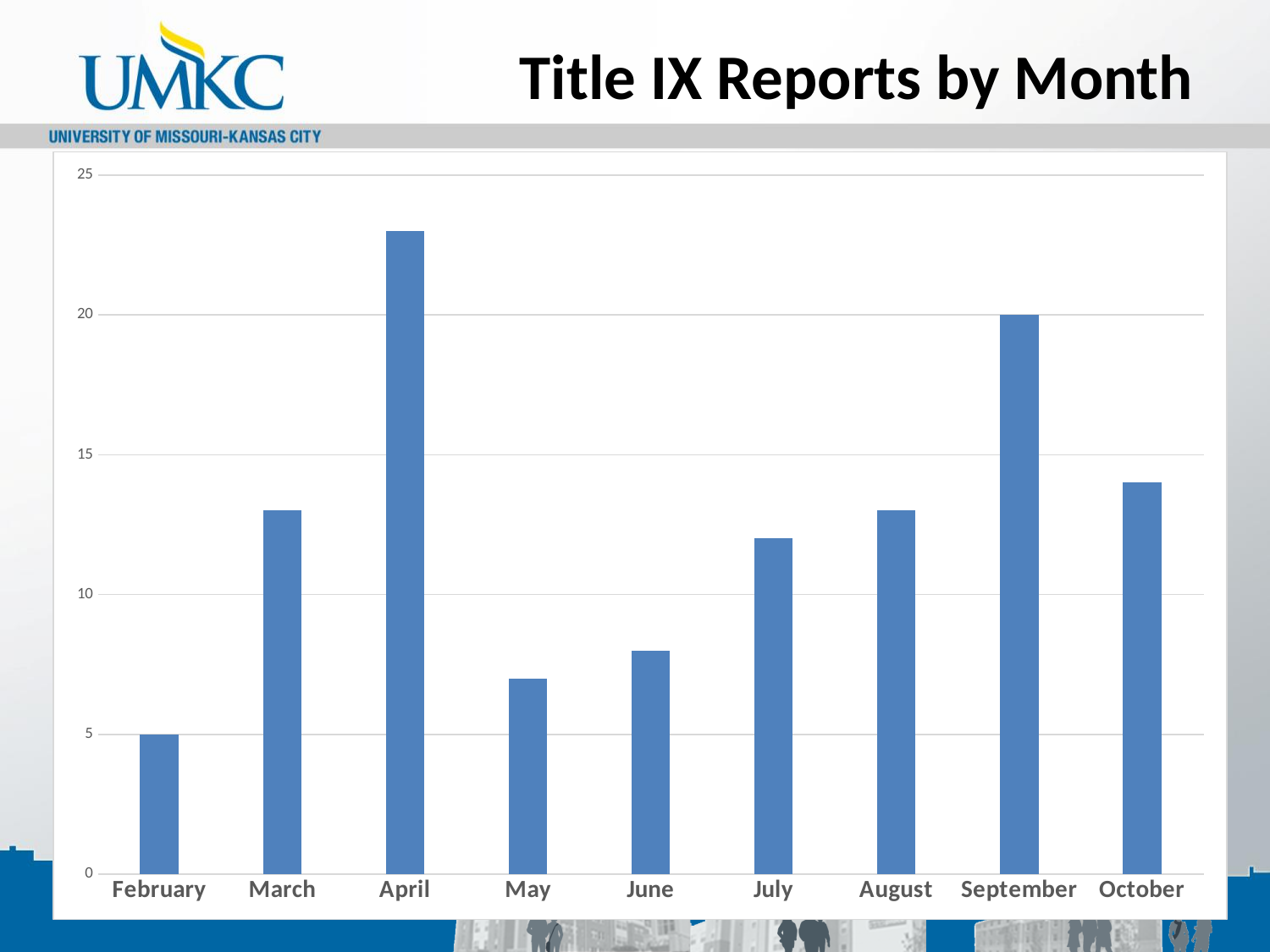
Which is larger, the value for April or the value for September? April What is the value for February? 5 Is the value for May greater or less than 10? less What kind of chart is shown on the slide? bar chart Is the value for October greater or less than 10? greater What is the value for September? 20 What is the title of the chart? Title IX Reports by Month Which month has the highest number of Title IX reports? April How many months are shown on the x axis of the chart? 9 Which month has the lowest number of Title IX reports? February Do the values rise or fall from February to April? rise What is the difference between the values for September and February? 15